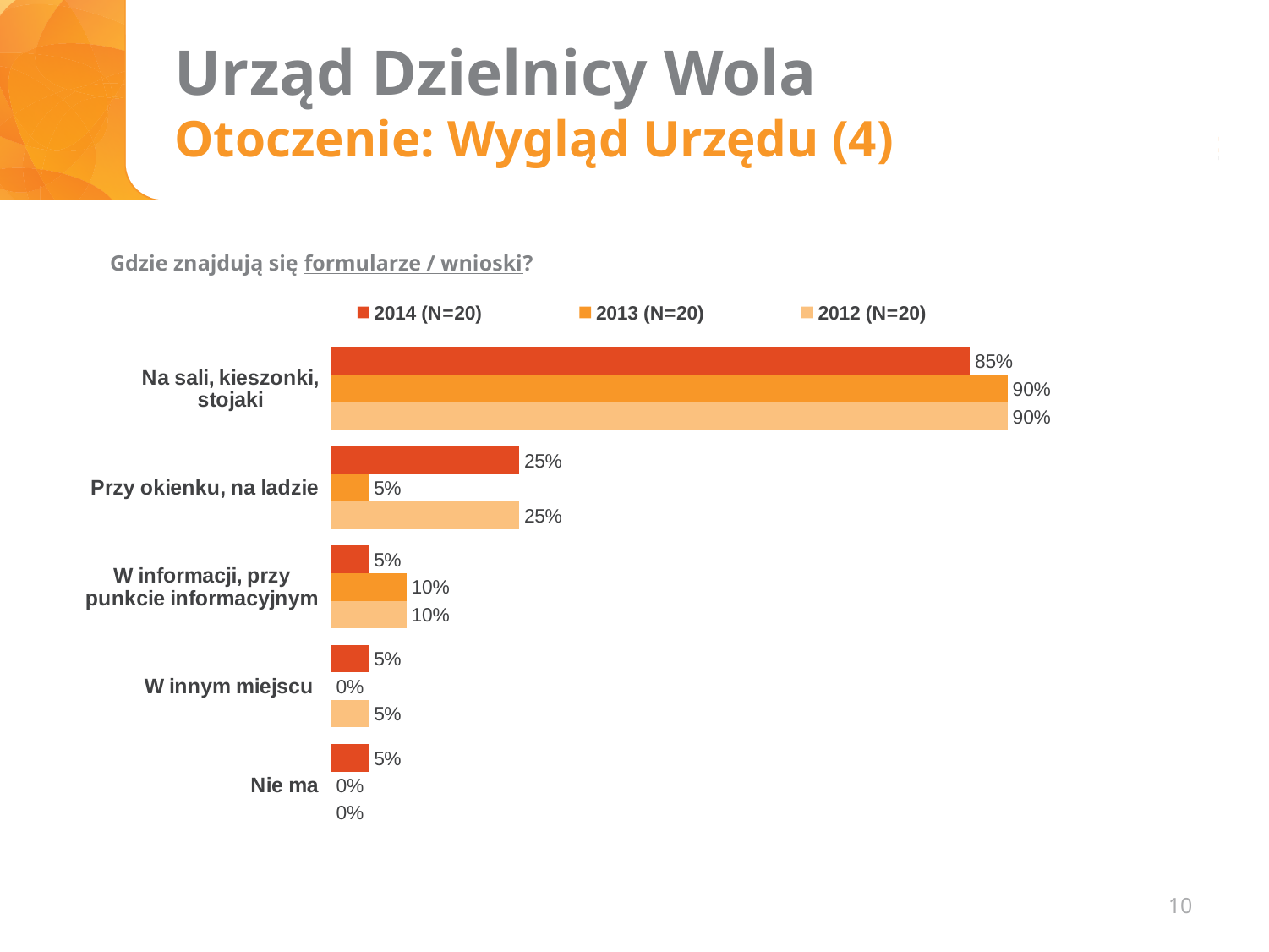
What is the value for "Przy okienku, na ladzie" in the 2013 (N=20) series? 5% What is the difference between the 2013 (N=20) and 2014 (N=20) values for "Na sali, kieszonki, stojaki"? 5% How many categories are shown on the chart? 5 What kind of chart is shown on the slide? bar chart What is the value for "W informacji, przy punkcie informacyjnym" in the 2012 (N=20) series? 10% Which category has the highest value in the 2013 (N=20) series? Na sali, kieszonki, stojaki Which is larger for "W informacji, przy punkcie informacyjnym": the 2014 (N=20) value or the 2013 (N=20) value? 2013 (N=20) What is the difference between the 2014 (N=20) and 2013 (N=20) values for "Przy okienku, na ladzie"? 20% What question does the chart answer, as stated above it? Gdzie znajdują się formularze / wnioski? How many series does the legend list? 3 What is the value for "Na sali, kieszonki, stojaki" in the 2014 (N=20) series? 85% What is the value for "Nie ma" in the 2014 (N=20) series? 5%